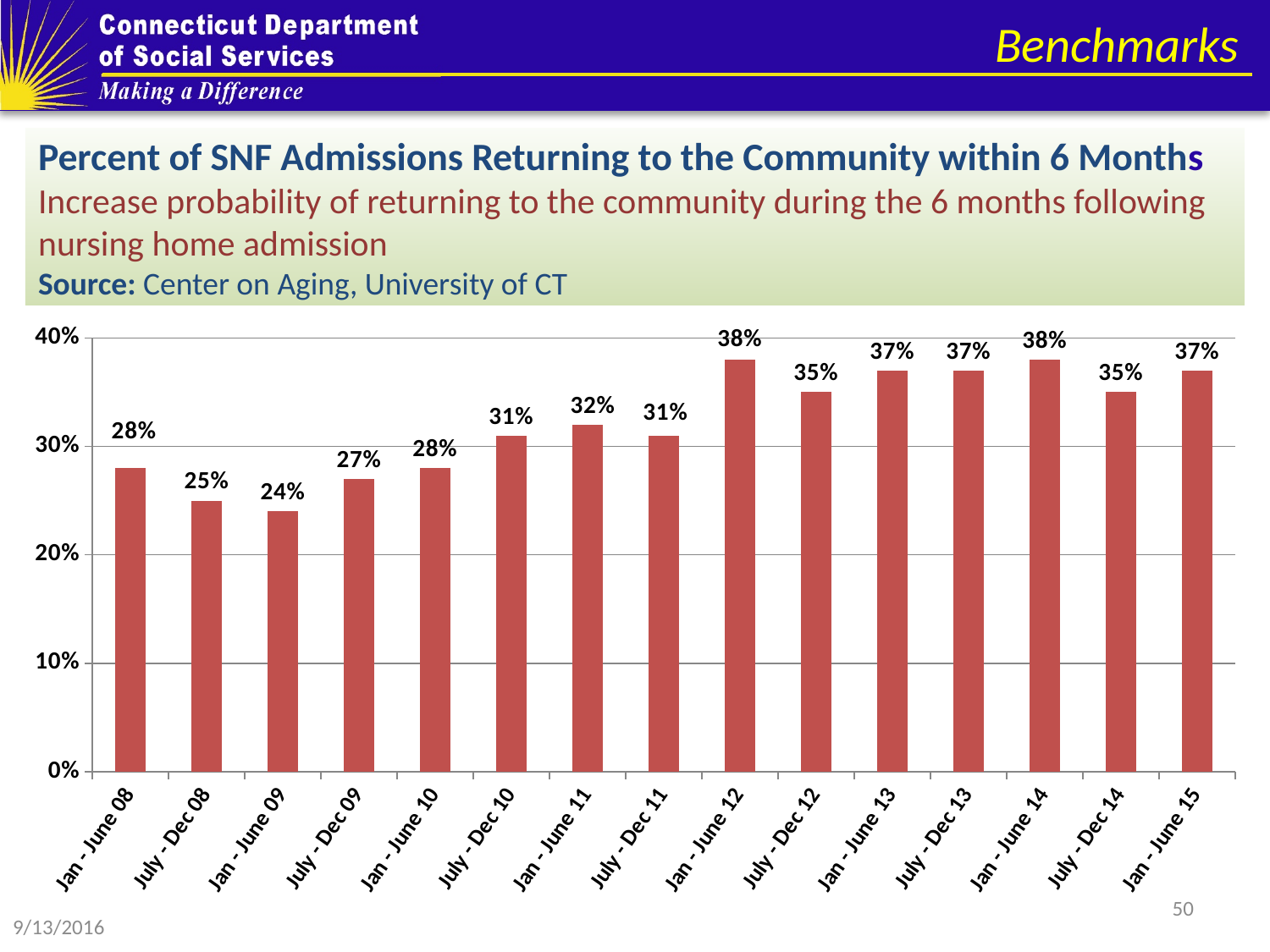
What is the value for Jan - June 09? 24% What is the value for July - Dec 14? 35% What is the value for Jan - June 15? 37% Do the values generally rise or fall from Jan - June 08 to Jan - June 15? rise What is the value for Jan - June 12? 38% What is the difference between the values for Jan - June 12 and Jan - June 08? 10% Which is larger, the value for July - Dec 12 or the value for Jan - June 13? Jan - June 13 Is the value for July - Dec 09 greater or less than 30%? less How many periods are shown on the x axis? 15 Which period has the lowest value? Jan - June 09 What is the highest value shown on the chart? 38% What kind of chart is shown on the slide? bar chart